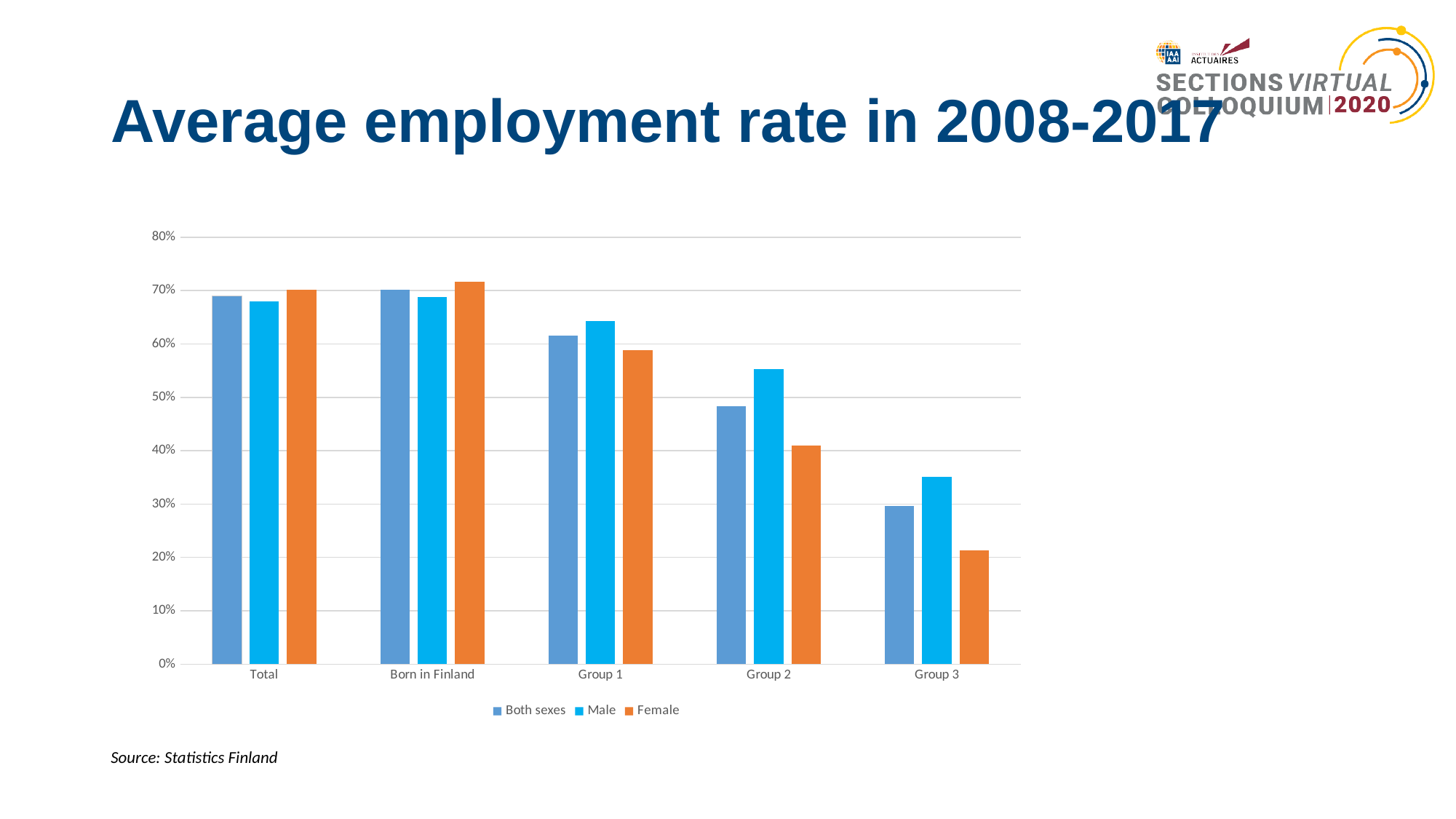
For Group 1, which is larger: the Male value or the Both sexes value? Male Is the Female value for Group 3 greater or less than 30%? less How many categories are shown on the x axis? 5 How many series does the legend list? 3 What source is cited for the chart? Statistics Finland Is the Male value for Group 2 greater or less than 50%? greater Which category has the lowest Female value? Group 3 Which category has the lowest Male value? Group 3 Do the Both sexes values rise or fall from Group 1 to Group 3? fall Is the Both sexes value for Group 2 greater or less than 50%? less What kind of chart is shown on the slide? bar chart For Group 2, which is larger: the Male value or the Female value? Male